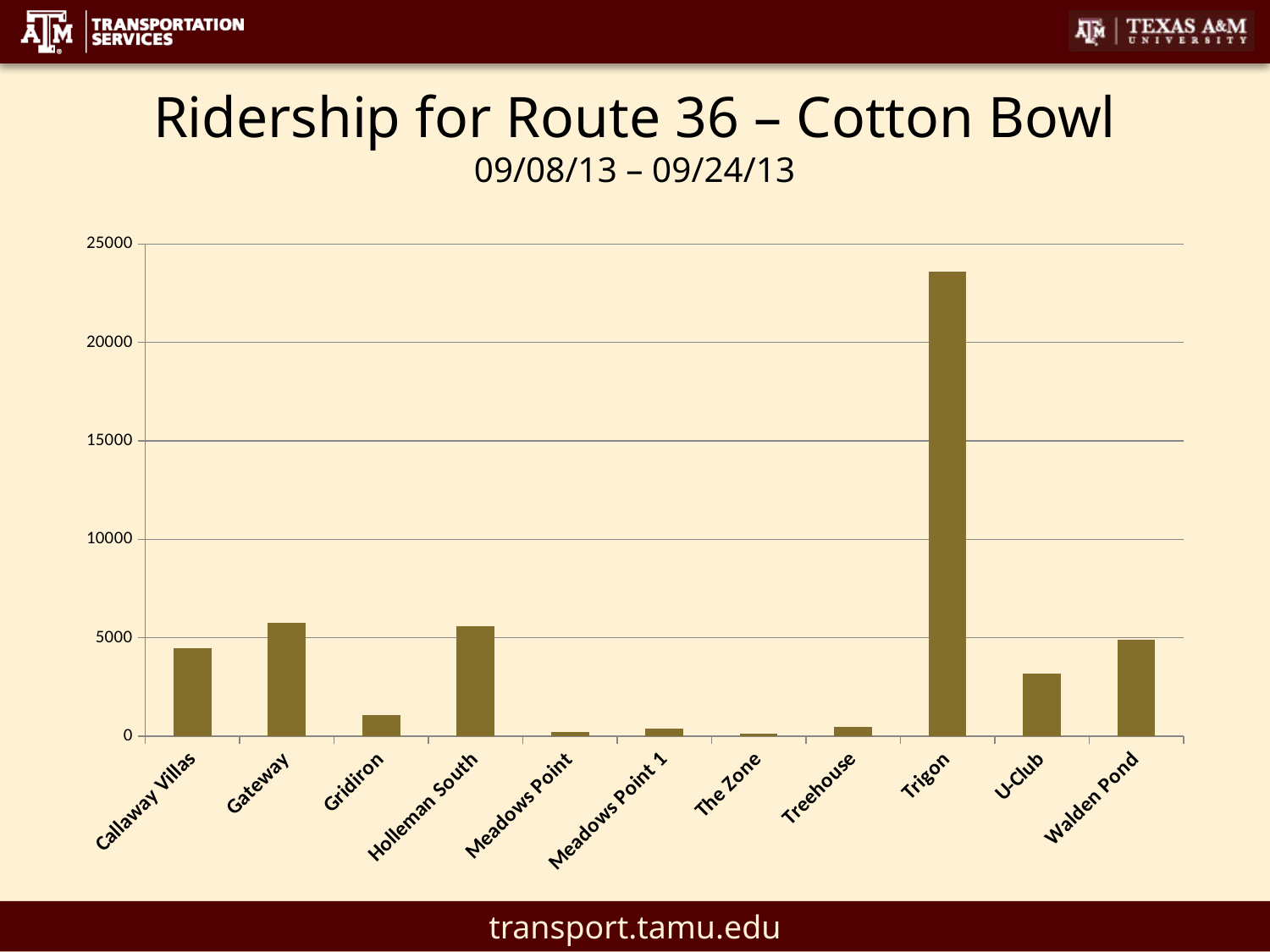
How many stops (categories) are shown on the x axis of the chart? 11 What date range does the chart cover, according to the subtitle? 09/08/13 – 09/24/13 Is the ridership value for Gridiron greater or less than 5000? less Is the ridership value for Gateway greater or less than 5000? greater Is the ridership value for Trigon greater or less than 20000? greater What is the title of the chart on the slide? Ridership for Route 36 – Cotton Bowl Which stop has higher ridership, U-Club or Treehouse? U-Club What kind of chart is shown on the slide? Bar chart Which stop has higher ridership, Gateway or Callaway Villas? Gateway Which stop has the highest ridership in the chart? Trigon